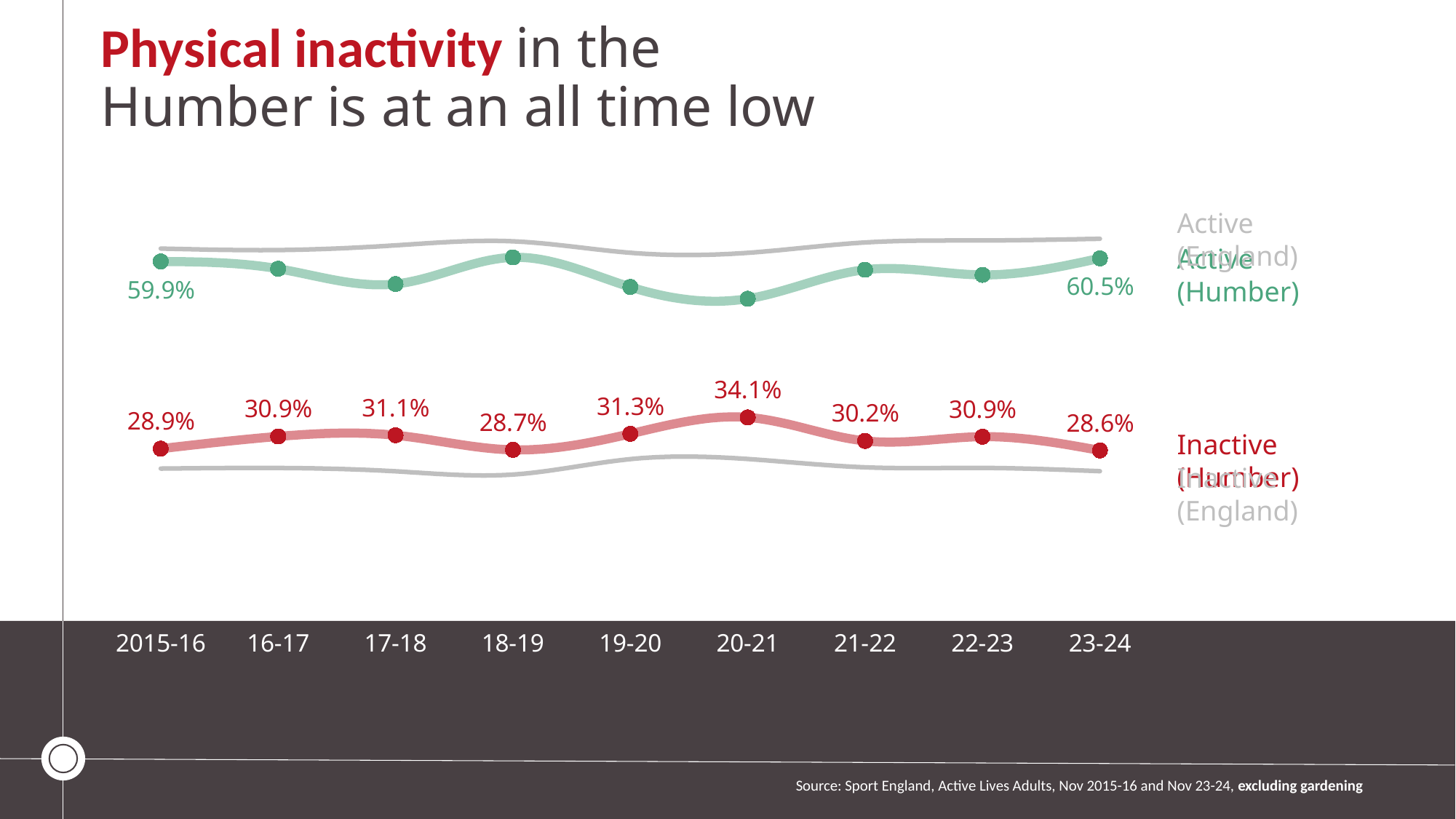
In which period is the Inactive (Humber) value highest? 20-21 What is the difference between the Inactive (Humber) values for 20-21 and 23-24? 5.5 percentage points How many time periods are shown on the x axis? 9 What is the Active (Humber) value for 23-24? 60.5% What is the Inactive (Humber) value for 18-19? 28.7% Which is larger, the Inactive (Humber) value for 16-17 or for 17-18? 17-18 How many series are labelled on the chart? 4 What kind of chart is shown on the slide? Line chart In which period is the Inactive (Humber) value lowest? 23-24 What is the Inactive (Humber) value for 20-21? 34.1% What is the difference between the Active (Humber) values for 23-24 and 2015-16? 0.6 percentage points What is the Active (Humber) value for 2015-16? 59.9%